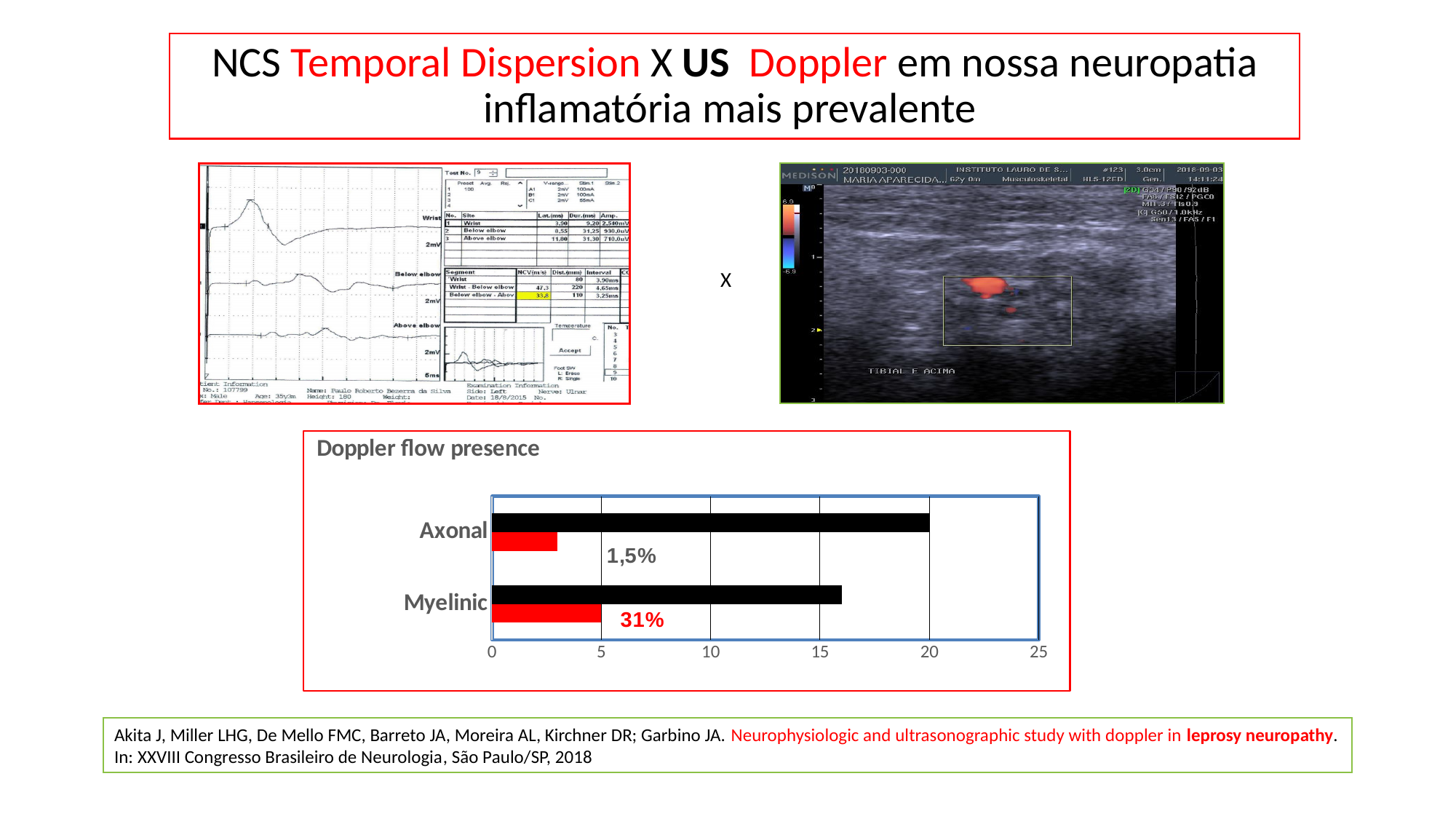
In the "Doppler flow presence" chart, is the red bar for Axonal greater or less than 5? less In the "Doppler flow presence" chart, is the black bar for Myelinic greater or less than 20? less In the "Doppler flow presence" chart, which category has the longer red bar, Axonal or Myelinic? Myelinic What are the two categories shown in the "Doppler flow presence" chart? Axonal and Myelinic In the "Doppler flow presence" chart, what percentage label is printed next to the red bar for Axonal? 1,5% In the "Doppler flow presence" chart, what percentage label is printed next to the red bar for Myelinic? 31% What is the title of the bar chart on the slide? Doppler flow presence What is the highest value shown on the x axis of the "Doppler flow presence" chart? 25 How many categories are shown on the y axis of the "Doppler flow presence" chart? 2 In the "Doppler flow presence" chart, which category has the longer black bar, Axonal or Myelinic? Axonal In the "Doppler flow presence" chart, is the black bar for Axonal greater or less than 15? greater What kind of chart is shown under the title "Doppler flow presence"? bar chart